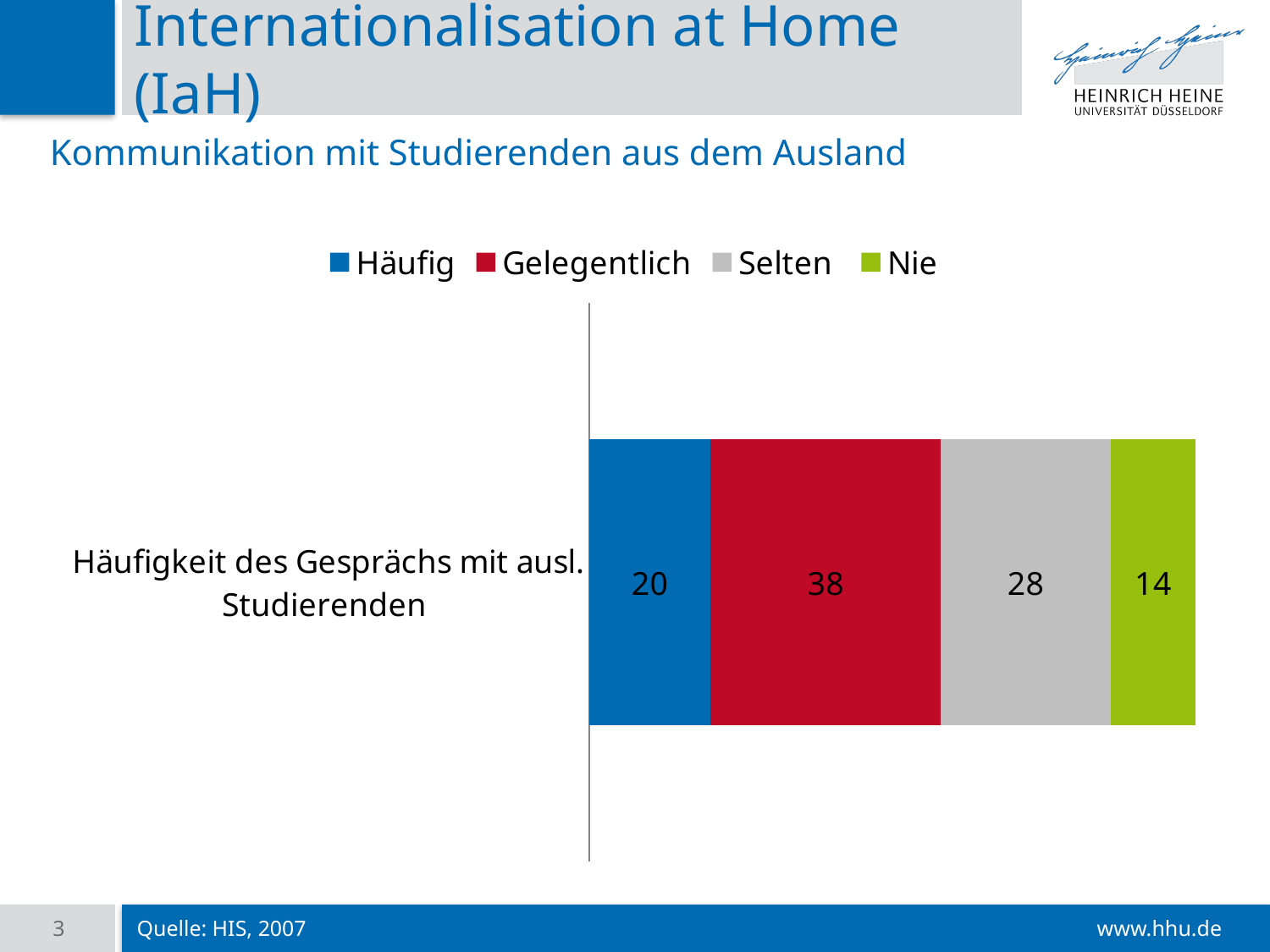
How many series does the legend list? 4 Which is larger, the value for Häufig or the value for Selten? Selten What is the value for Selten in the stacked bar? 28 What colour represents the Nie series in the chart? Green What kind of chart is shown on the slide? Stacked bar chart What is the value for Gelegentlich in the stacked bar? 38 What is the total of the stacked bar? 100 What is the value for Häufig in the stacked bar? 20 What is the difference between the values for Gelegentlich and Selten? 10 What is the value for Nie in the stacked bar? 14 Which series has the lowest value in the bar? Nie Which series has the highest value in the bar? Gelegentlich